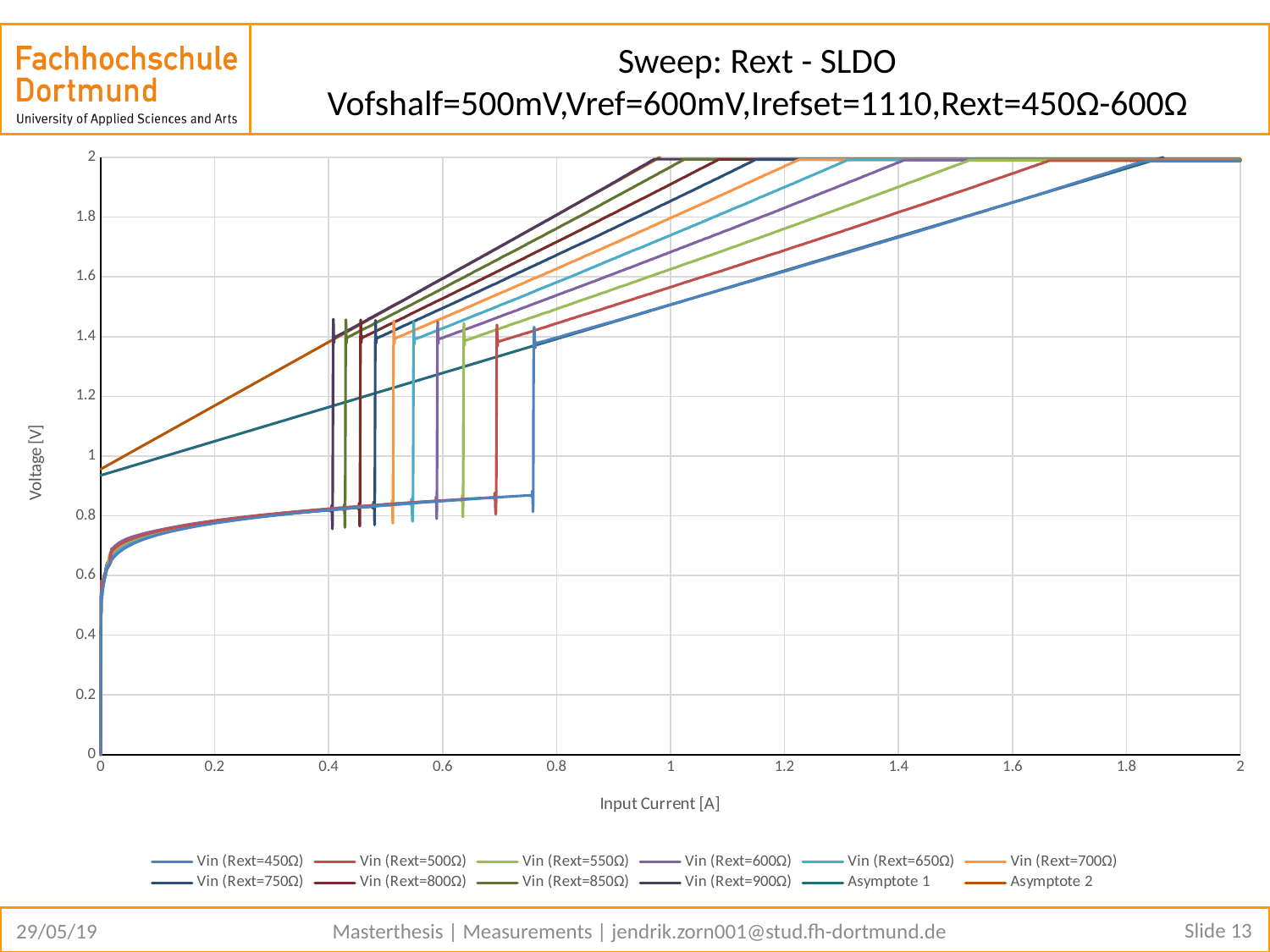
Does Asymptote 2 rise or fall as input current increases from 0 to 1 A? rise What is the first line of the chart title? Sweep: Rext - SLDO At an input current of 0.2 A, which is higher, Asymptote 2 or Vin (Rext=450Ω)? Asymptote 2 At an input current of 1.8 A, is the value of Asymptote 1 greater or less than 1.8? greater What is the label of the x axis? Input Current [A] At an input current of 0.2 A, is the value of Asymptote 1 greater or less than 0.8? greater How many series does the legend list? 12 At an input current of 1.2 A, is the value of Vin (Rext=450Ω) greater or less than 1.4? greater What kind of chart is shown on the slide? line chart Does Vin (Rext=450Ω) rise or fall as input current increases from 0 to 0.6 A? rise